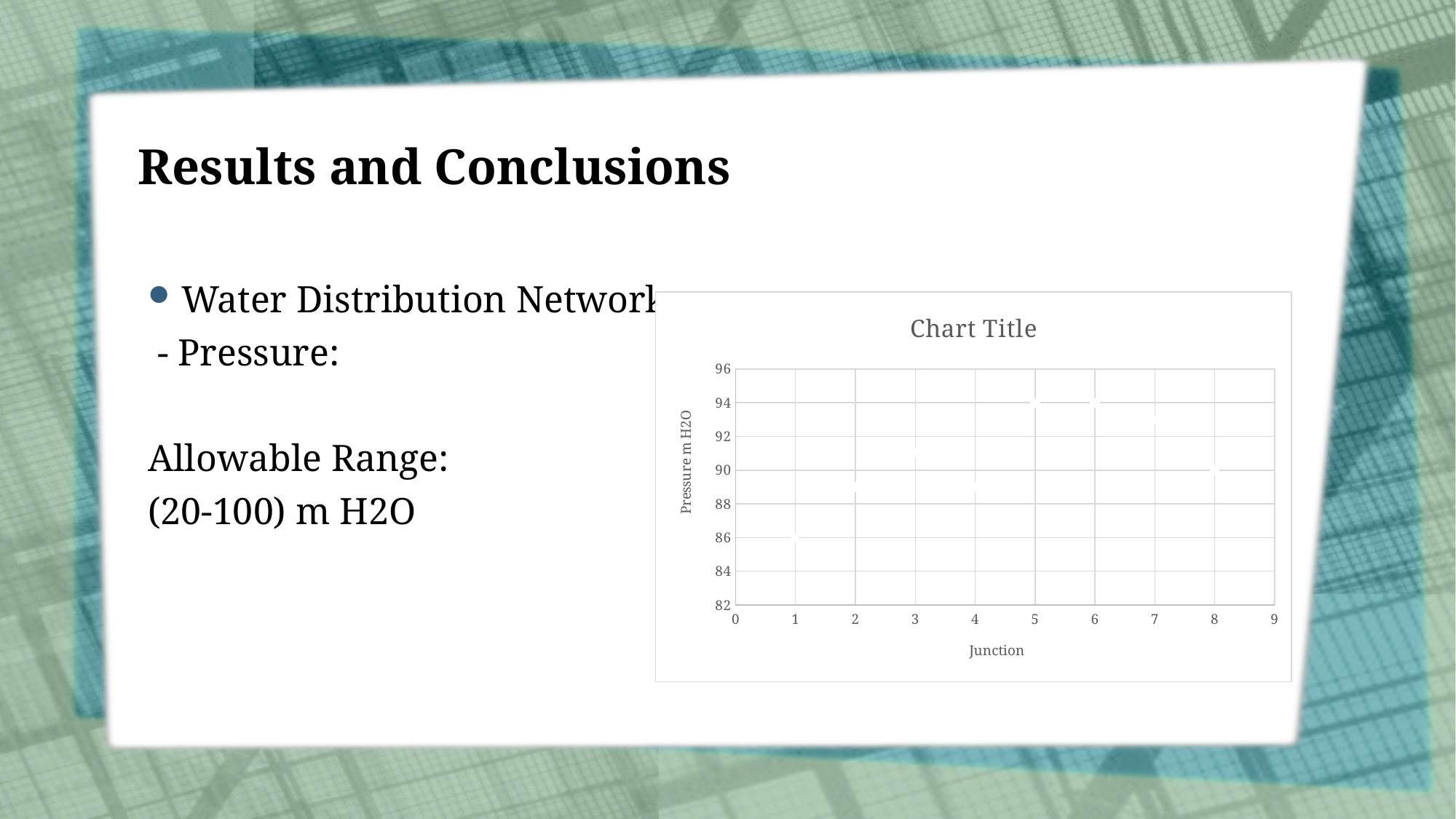
What kind of chart is shown on the slide? scatter chart What is the label of the vertical axis of the chart? Pressure m H2O Is the pressure value at junction 1 greater or less than 90? less Is the pressure value at junction 5 greater or less than 90? greater Is the pressure value at junction 6 greater or less than 90? greater Which has the higher pressure value, junction 1 or junction 5? junction 5 What is the title of the chart? Chart Title